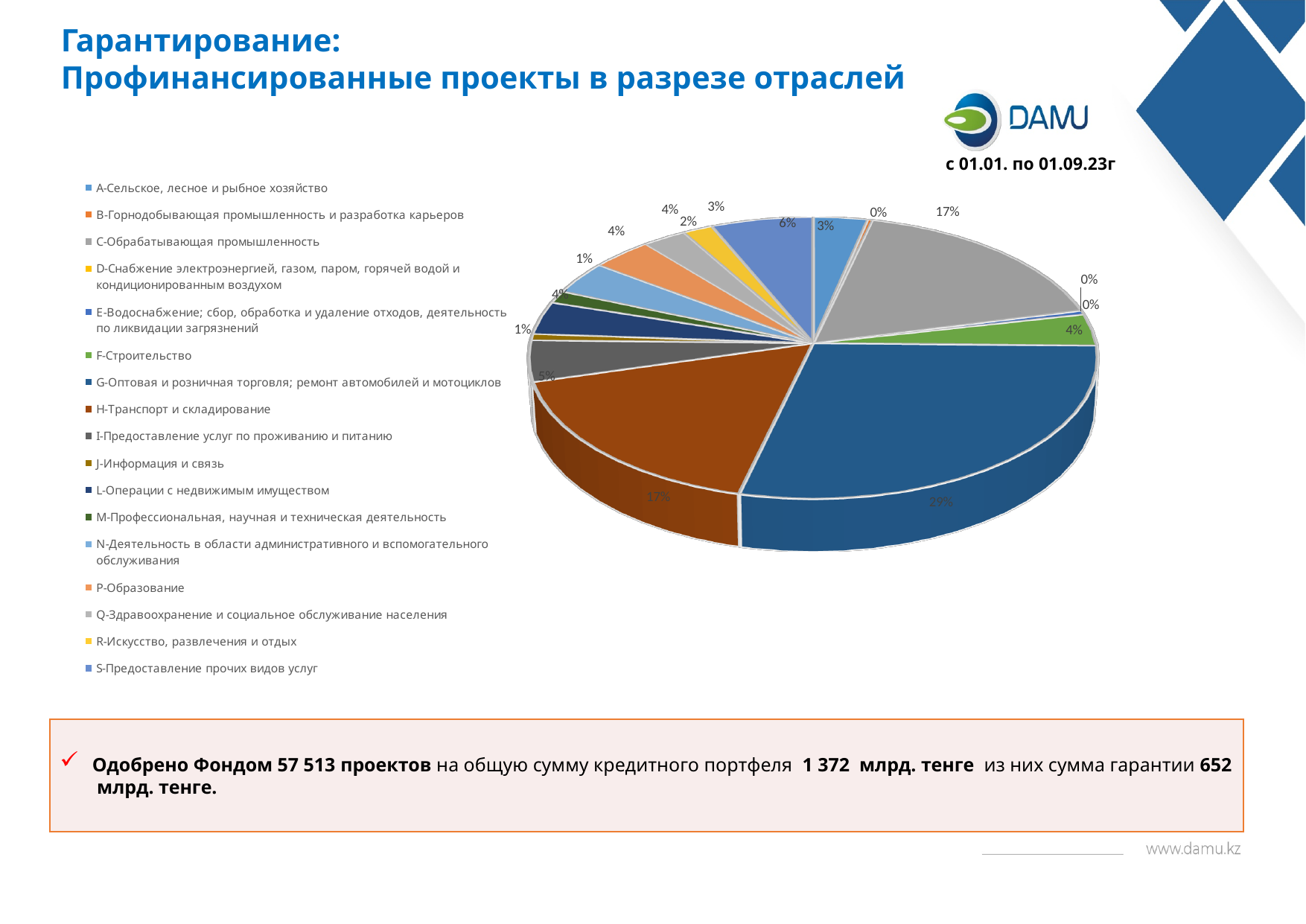
What is the share of S-Предоставление прочих видов услуг? 6% What share of the pie does C-Обрабатывающая промышленность have? 17% What share of the pie does G-Оптовая и розничная торговля; ремонт автомобилей и мотоциклов have? 29% Which category has the largest slice of the pie? G-Оптовая и розничная торговля; ремонт автомобилей и мотоциклов What kind of chart is shown on the slide? Pie chart Which is larger: the share of G-Оптовая и розничная торговля or the share of H-Транспорт и складирование? G-Оптовая и розничная торговля How many categories does the legend list? 17 What period does the chart cover, according to the slide? с 01.01. по 01.09.23г By how many percentage points does the share of G-Оптовая и розничная торговля exceed the share of C-Обрабатывающая промышленность? 12 percentage points